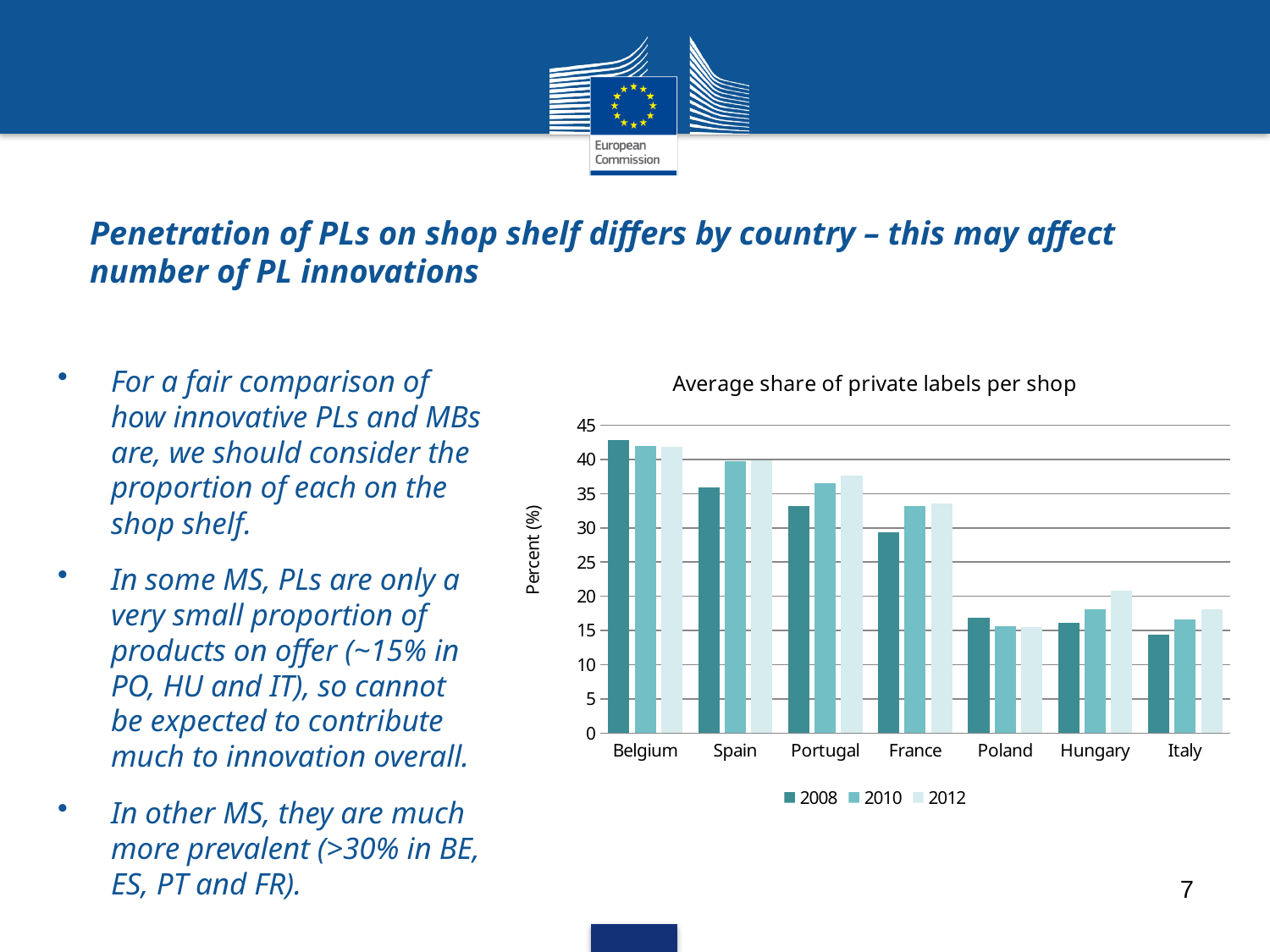
What is the title of the chart? Average share of private labels per shop Which country has the lowest value for 2012? Poland What kind of chart is shown on the slide? Bar chart Is the value for France in 2012 greater or less than 30? greater How many series does the chart's legend list? 3 Which is larger, the 2012 value for Spain or the 2012 value for Portugal? Spain Which country has the highest value for 2008? Belgium Which country has the lowest value for 2008? Italy How many countries are shown on the x axis of the chart? 7 Is the value for Belgium in 2008 greater or less than 40? greater Is the value for Poland in 2012 greater or less than 20? less Do the values for Hungary rise or fall from 2008 to 2012? Rise